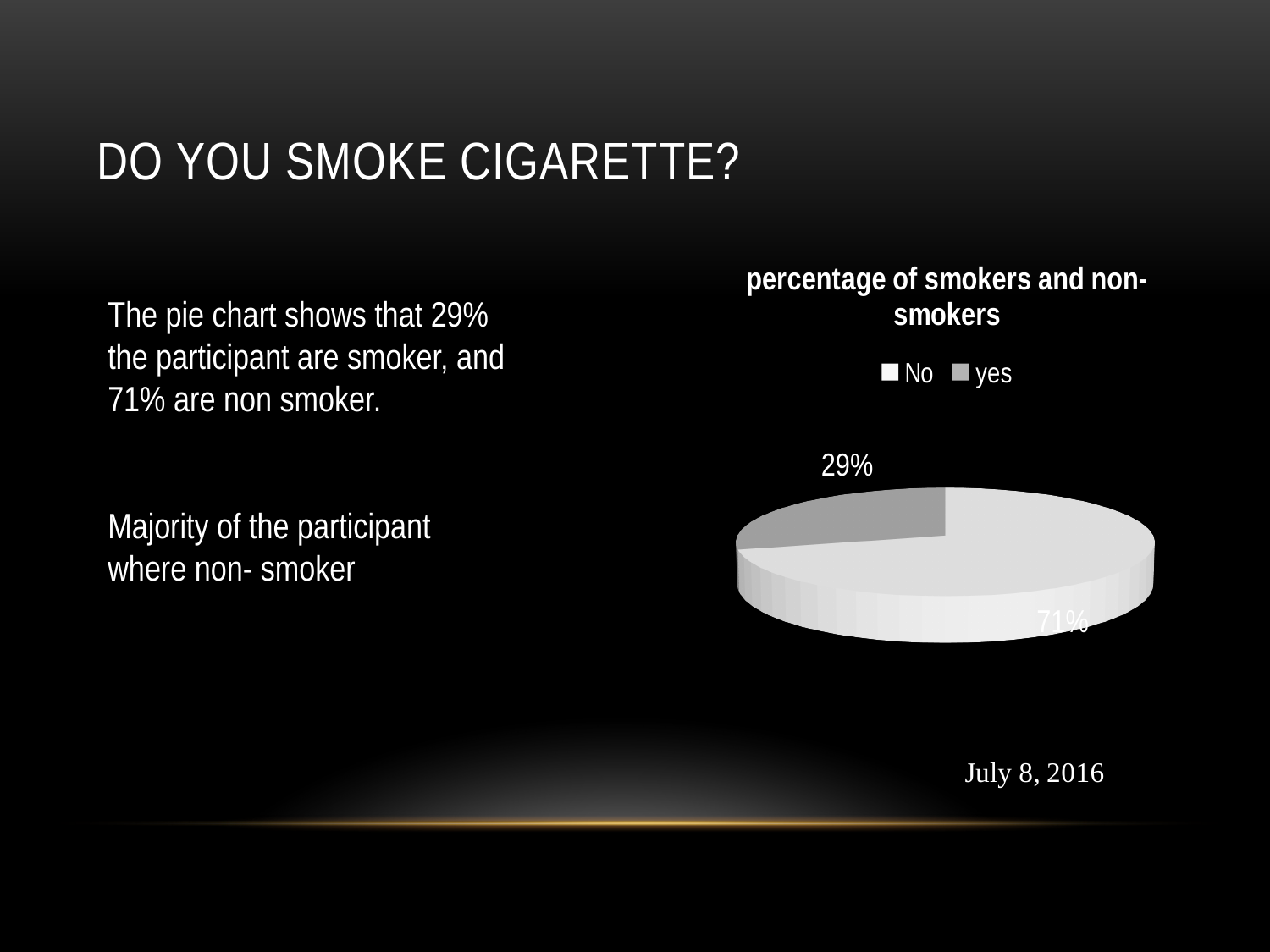
How many entries does the legend list? 2 What kind of chart is shown on the slide? pie chart How many slices does the pie chart have? 2 Which is larger, the "No" slice or the "yes" slice? No Which slice of the pie is the smallest? yes What share of the pie does the "No" slice represent? 71% What is the title of the chart? percentage of smokers and non-smokers Which slice of the pie is the largest? No What share of the pie does the "yes" slice represent? 29% Which legend entry is shown in the darker grey colour? yes What is the difference in percentage points between the "No" slice and the "yes" slice? 42